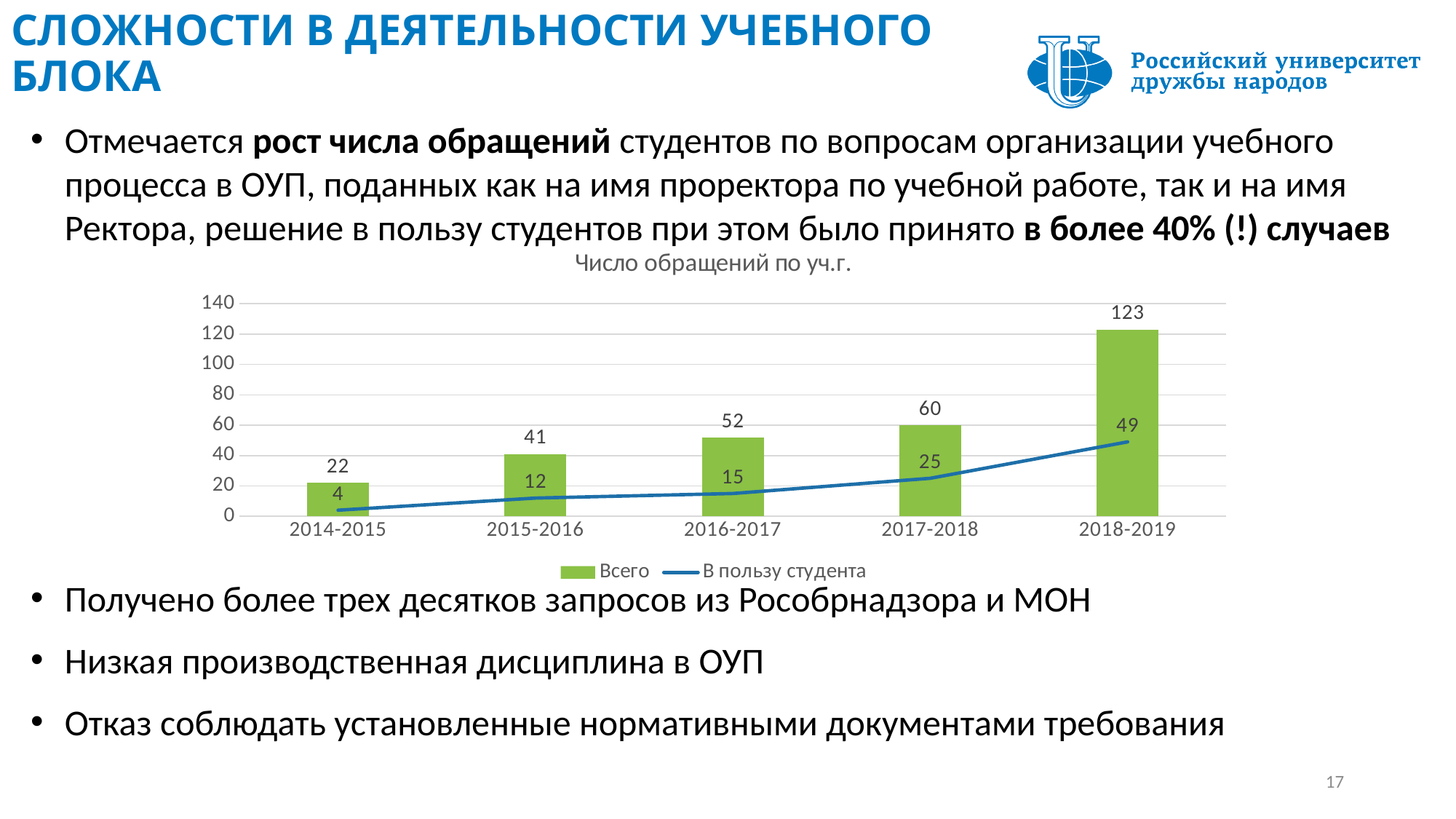
What is the difference between "Всего" and "В пользу студента" in 2017-2018? 35 Which is larger: "Всего" in 2016-2017 or "Всего" in 2017-2018? 2017-2018 What is the value of "В пользу студента" for 2016-2017? 15 How many academic years are shown on the x axis? 5 What is the title of the chart? Число обращений по уч.г. What kind of chart is used for the "Всего" series? bar chart What is the value of "Всего" for 2018-2019? 123 What is the value of "Всего" for 2015-2016? 41 How many series does the legend list? 2 Which academic year has the highest value for "Всего"? 2018-2019 Do the values of "Всего" rise or fall from 2014-2015 to 2018-2019? rise Which academic year has the lowest value for "В пользу студента"? 2014-2015